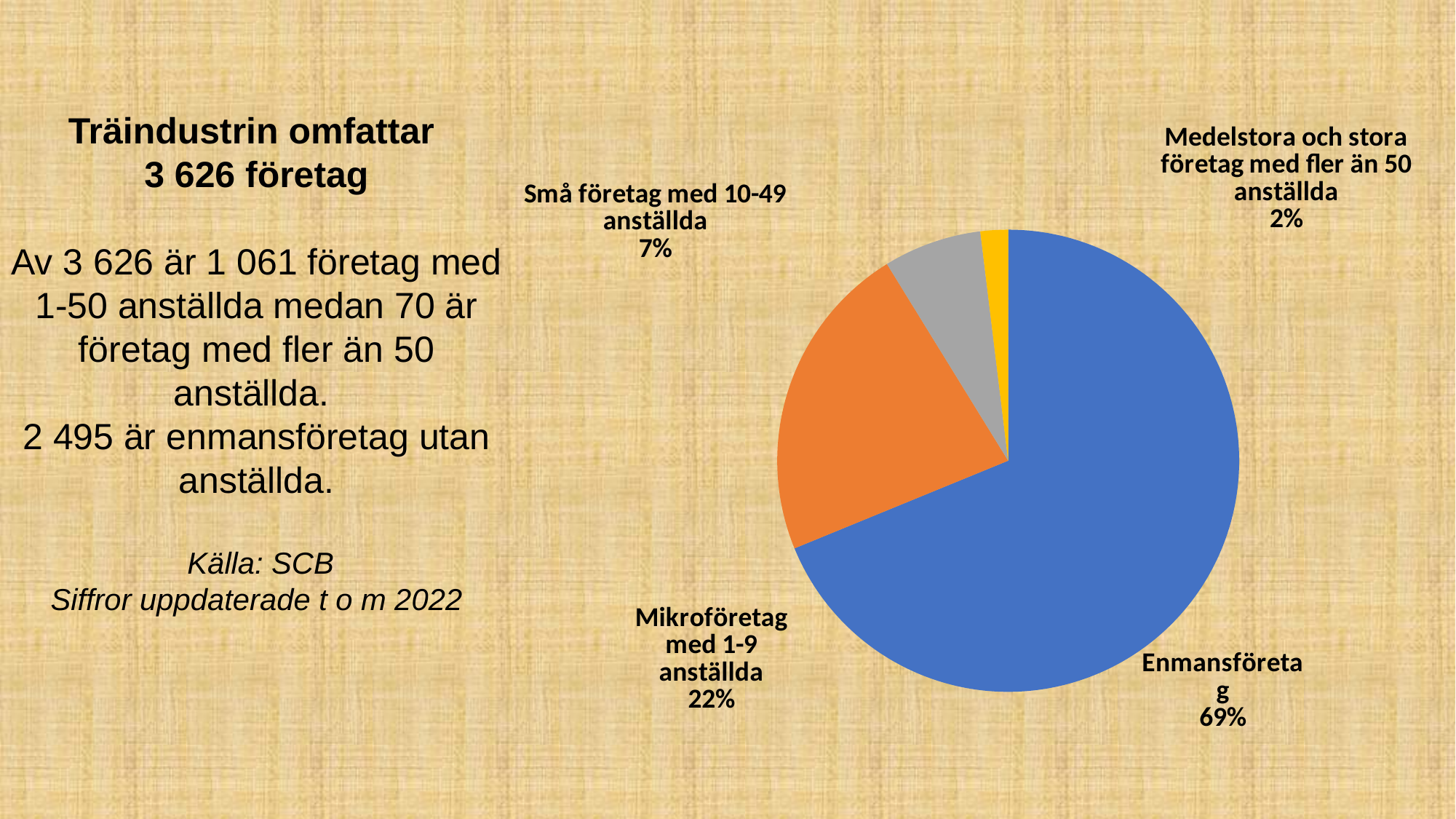
What share of the pie does Mikroföretag med 1-9 anställda have? 22% What is the difference in percentage points between Enmansföretag and Mikroföretag med 1-9 anställda? 47 Which category has the smallest slice of the pie? Medelstora och stora företag med fler än 50 anställda What share of the pie does Medelstora och stora företag med fler än 50 anställda have? 2% What share of the pie does Små företag med 10-49 anställda have? 7% What colour is the slice for Enmansföretag? blue How many slices does the pie chart have? 4 What colour is the slice for Mikroföretag med 1-9 anställda? orange What kind of chart is shown on the slide? pie chart Which category has the largest slice of the pie? Enmansföretag Which is larger, the slice for Små företag med 10-49 anställda or the slice for Medelstora och stora företag med fler än 50 anställda? Små företag med 10-49 anställda